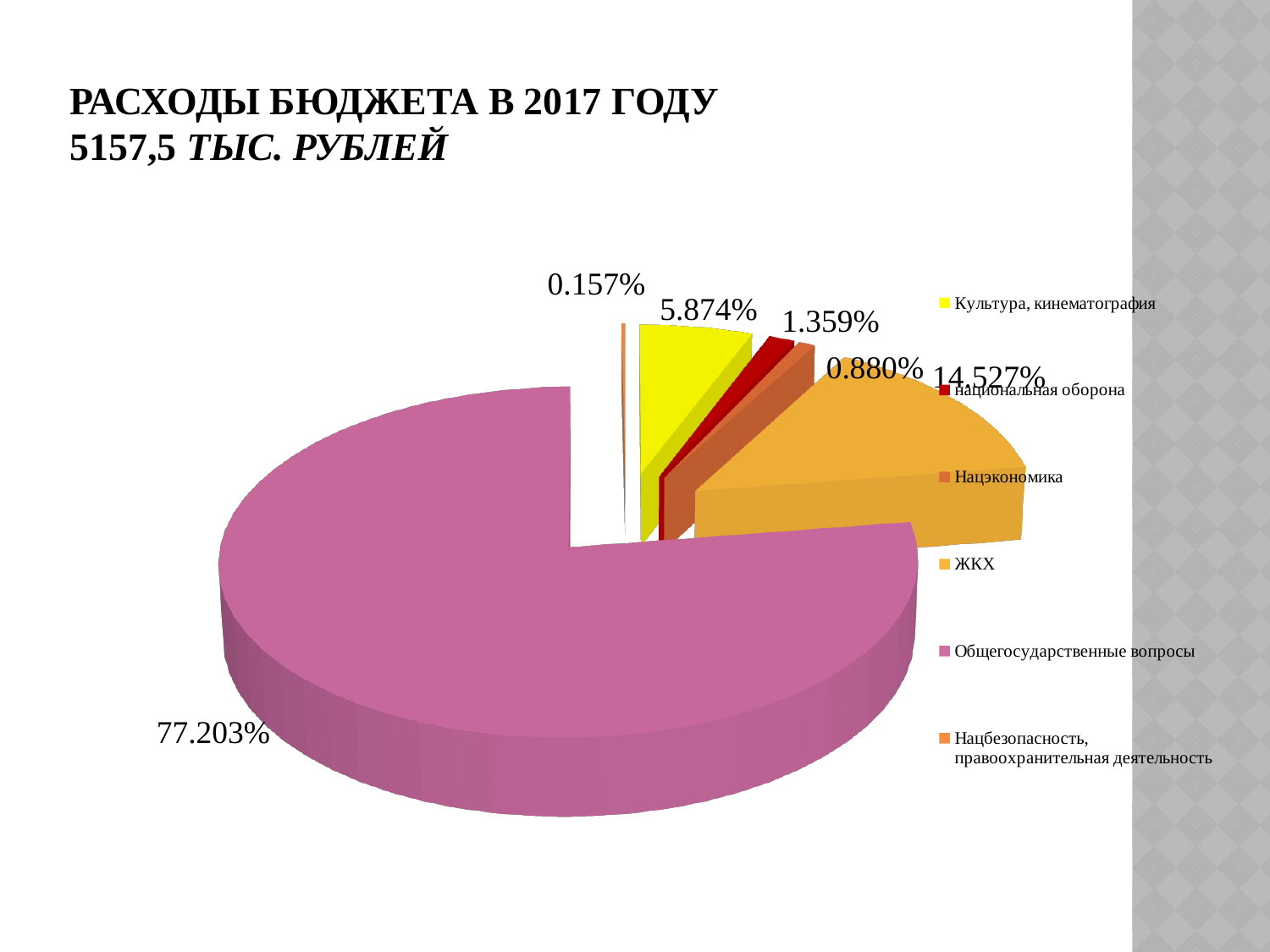
What is the value shown for Нацэкономика? 0.880% Which category has the largest slice of the pie? Общегосударственные вопросы What is the difference between the shares of ЖКХ and Культура, кинематография? 8.653% What is the value shown for Культура, кинематография? 5.874% Which is larger, the share for Национальная оборона or the share for Нацэкономика? Национальная оборона Which category has the smallest slice of the pie? Нацбезопасность, правоохранительная деятельность What share of the pie does Общегосударственные вопросы take? 77.203% How many categories does the legend list? 6 What is the value shown for ЖКХ? 14.527% What kind of chart is shown on the slide? Pie chart What is the value shown for Национальная оборона? 1.359% What is the title of the slide above the chart? РАСХОДЫ БЮДЖЕТА В 2017 ГОДУ 5157,5 ТЫС. РУБЛЕЙ